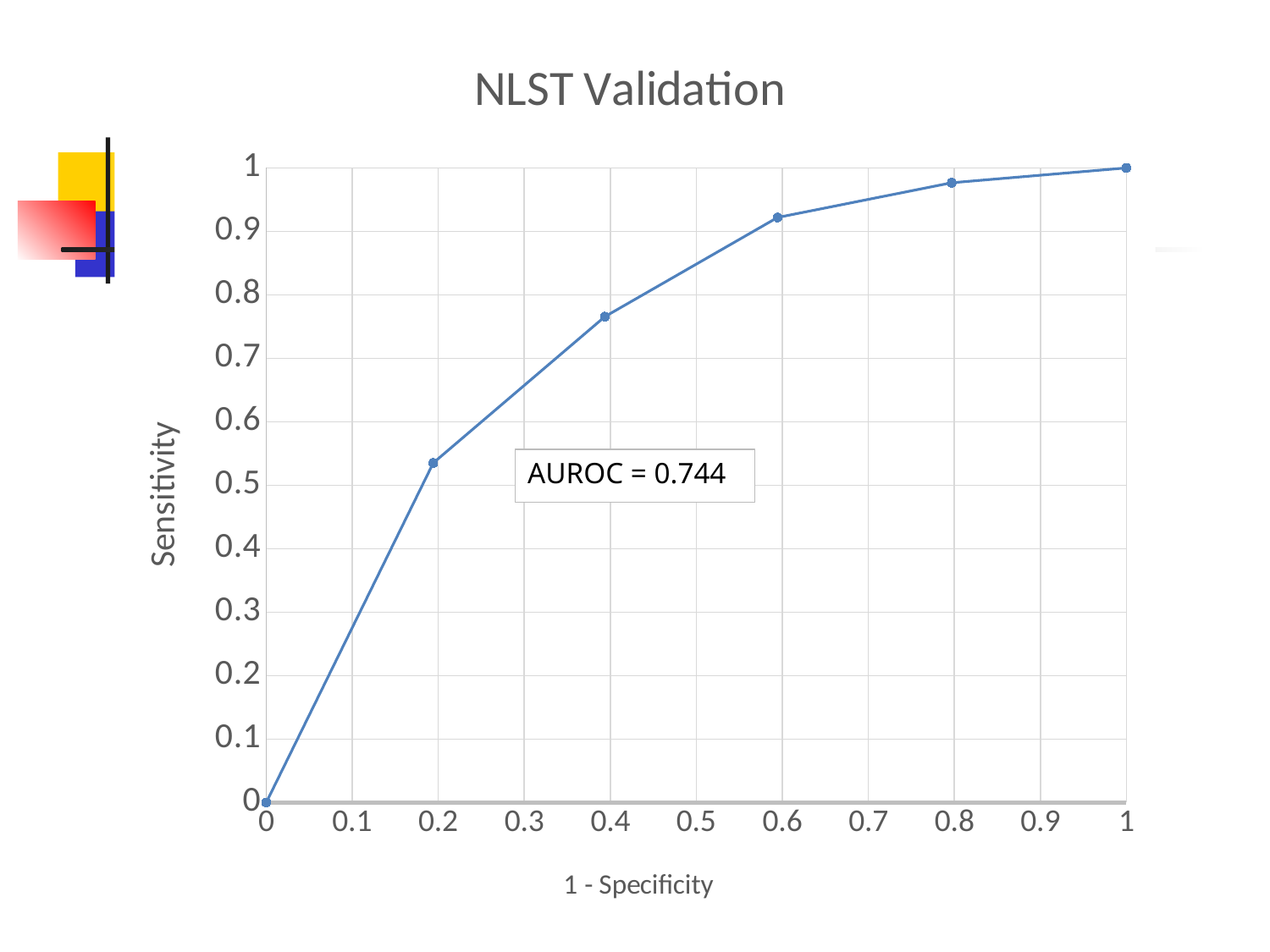
What is the label of the y axis? Sensitivity What kind of chart is shown on the slide? line chart What is the sensitivity value at 1 - Specificity = 1? 1 Is the sensitivity at the point near 1 - Specificity = 0.8 greater or less than 0.9? greater Does sensitivity rise or fall as 1 - Specificity increases along the x axis? rise Is the sensitivity at the point near 1 - Specificity = 0.2 greater or less than 0.5? greater What AUROC value is printed on the chart? 0.744 Which is larger: the sensitivity at 1 - Specificity near 0.2 or near 0.4? near 0.4 How many data points are plotted on the curve? 6 Is the sensitivity at the point near 1 - Specificity = 0.4 greater or less than 0.8? less What is the title of the chart? NLST Validation